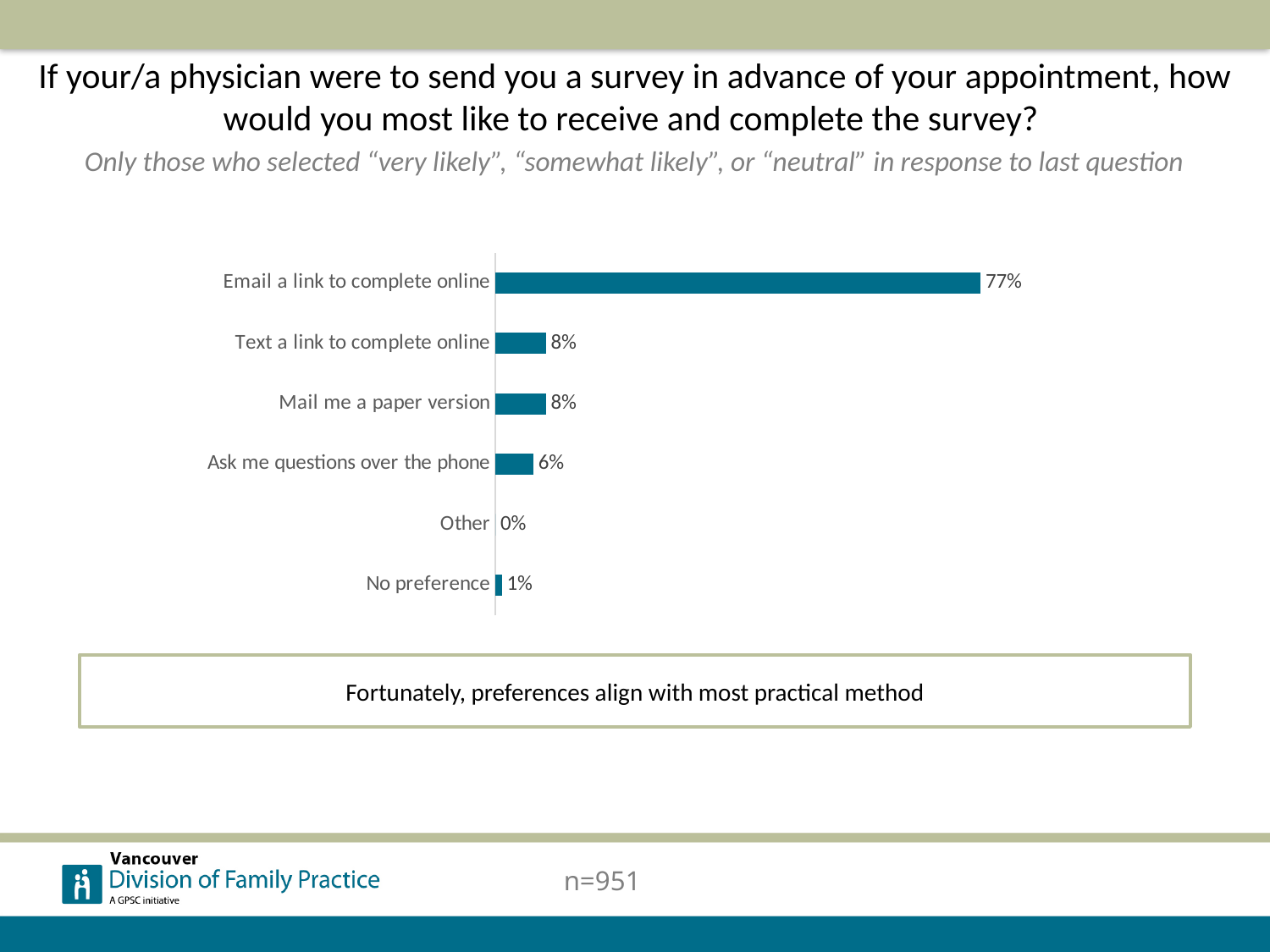
What is the value for "No preference"? 1% What is the sample size (n) shown on the slide? n=951 What is the value for "Other"? 0% Which is larger: the value for "Mail me a paper version" or "Ask me questions over the phone"? Mail me a paper version Which category has the highest value? Email a link to complete online How many categories are shown in the chart? 6 What is the difference between "Email a link to complete online" and "Text a link to complete online"? 69 percentage points What kind of chart is shown on the slide? Bar chart What is the value for "Ask me questions over the phone"? 6% Which category has the lowest value? Other What is the difference between "Mail me a paper version" and "Ask me questions over the phone"? 2 percentage points What percentage of respondents chose "Email a link to complete online"? 77%